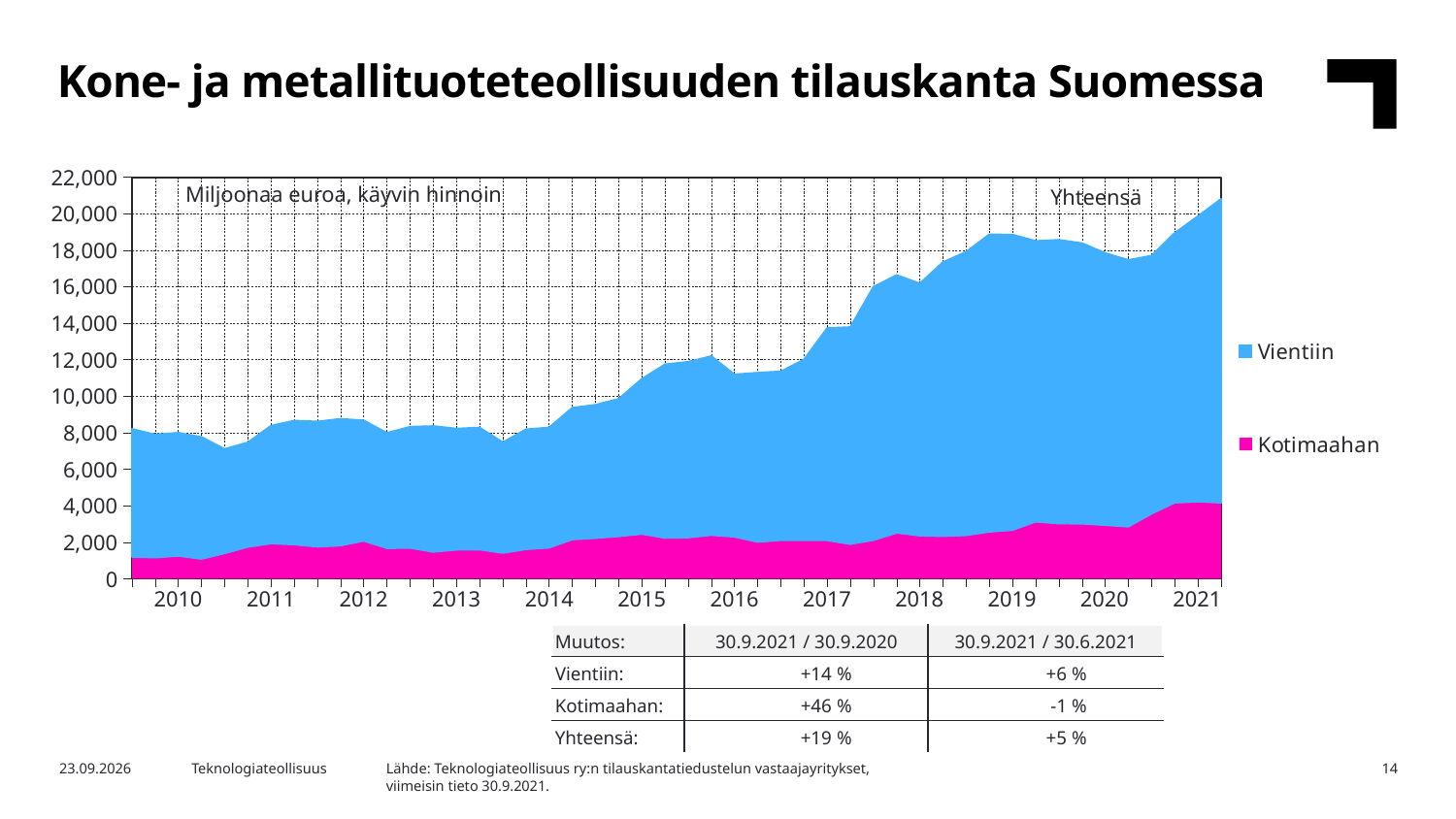
What are the two series named in the chart legend? Vientiin and Kotimaahan Which series is larger throughout the chart, Vientiin or Kotimaahan? Vientiin Does the total order backlog rise or fall overall from 2010 to 2021? rise In which year does the total (Yhteensä) reach its highest level? 2021 What kind of chart is shown on the slide? Area chart Is the total value at the start of 2010 greater or less than 10,000? less What unit label is shown inside the chart area? Miljoonaa euroa, käyvin hinnoin Is the Kotimaahan value in 2010 greater or less than 2,000? less How many series does the chart legend list? 2 In which year is the total (Yhteensä) at its lowest level? 2010 Is the total value at the start of 2019 greater or less than 18,000? greater How many years are labelled on the x axis of the chart? 12